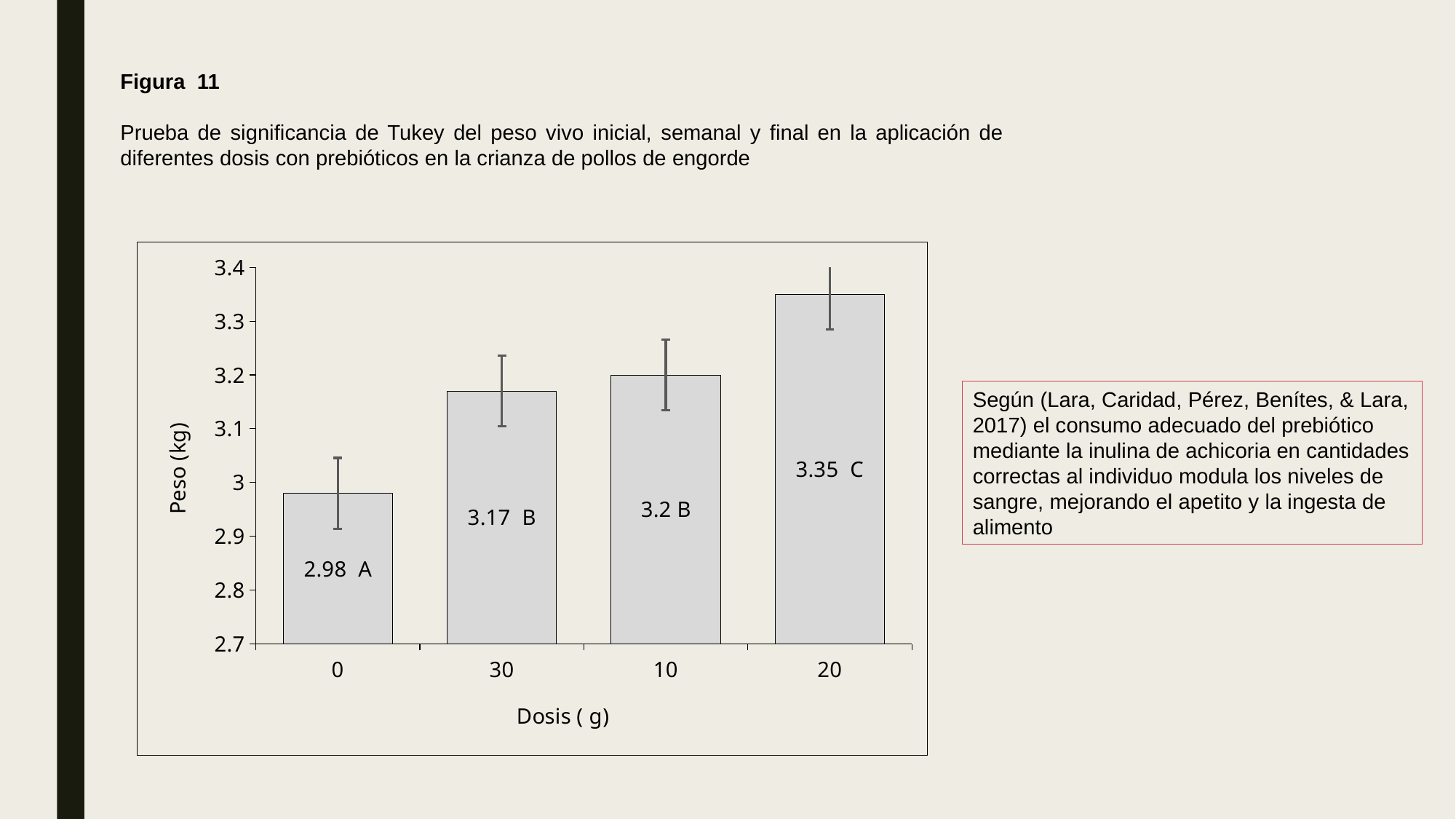
What is the weight (Peso) for dose 20 g? 3.35 Which Tukey significance letter is shown on the bar for dose 20 g? C What is the label of the y axis? Peso (kg) Which dose has the lowest weight? 0 What kind of chart is shown? bar chart How many dose categories are shown on the x axis? 4 What is the difference in weight between dose 20 g and dose 0 g? 0.37 What is the weight (Peso) for dose 10 g? 3.2 Which has a larger weight, dose 30 g or dose 20 g? 20 What is the weight (Peso) for dose 0 g? 2.98 Is the weight for dose 0 g greater or less than 3? less Which dose has the highest weight? 20